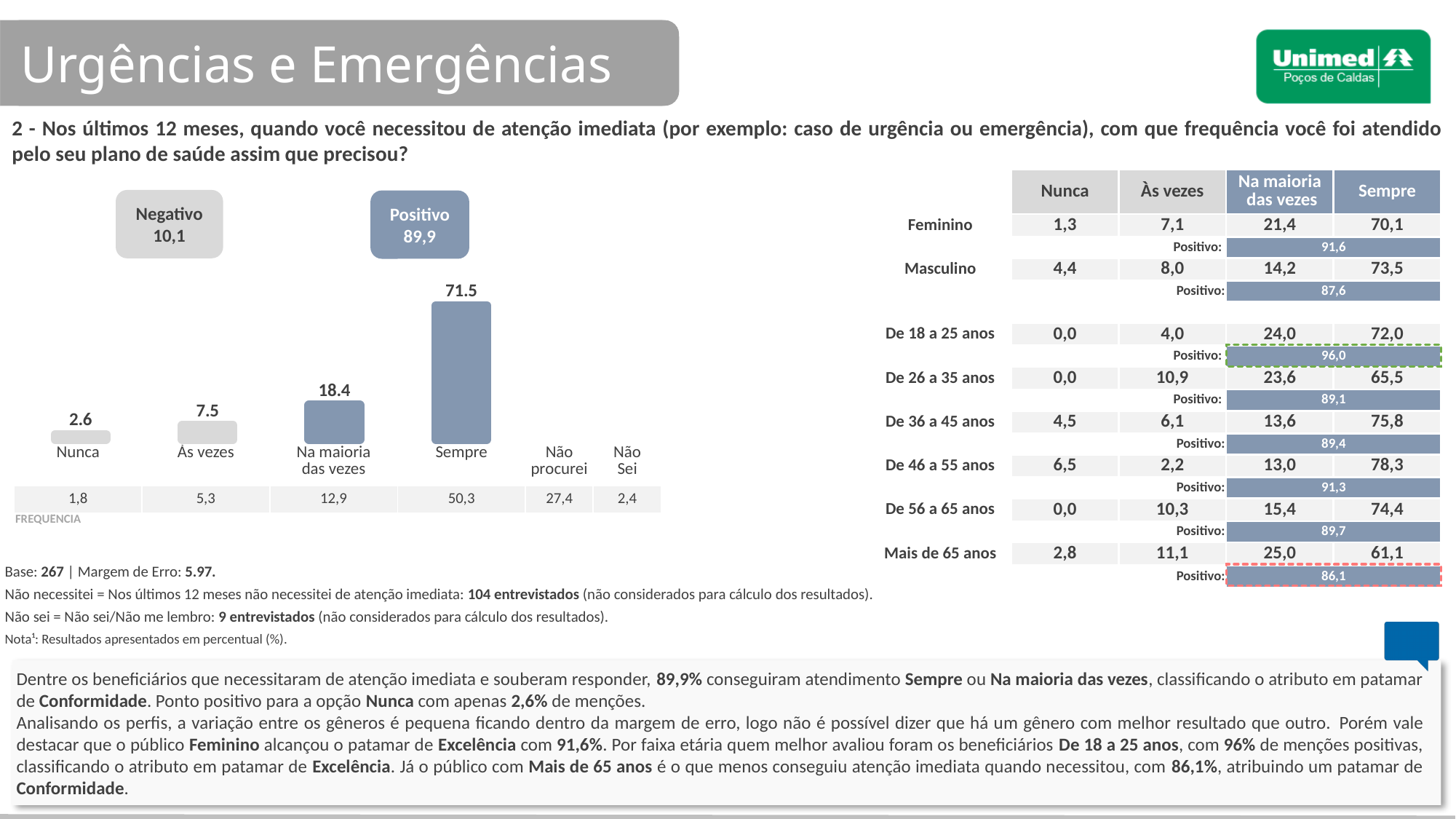
Which category has the lowest bar in the bar chart? Nunca What is the value shown for the 'Na maioria das vezes' bar in the bar chart? 18.4 Which category has the highest bar in the bar chart? Sempre What value is shown in the 'Negativo' box above the bar chart? 10,1 Which is larger in the bar chart, 'Às vezes' or 'Na maioria das vezes'? Na maioria das vezes What is the value shown for the 'Às vezes' bar in the bar chart? 7.5 What is the value shown for the 'Sempre' bar in the bar chart? 71.5 What value is shown in the 'Positivo' box above the bar chart? 89,9 What type of chart is used to show the response frequencies on the slide? Bar chart What is the difference between the 'Sempre' bar and the 'Na maioria das vezes' bar in the bar chart? 53.1 What is the value shown for the 'Nunca' bar in the bar chart? 2.6 How many bars are plotted in the bar chart? 4